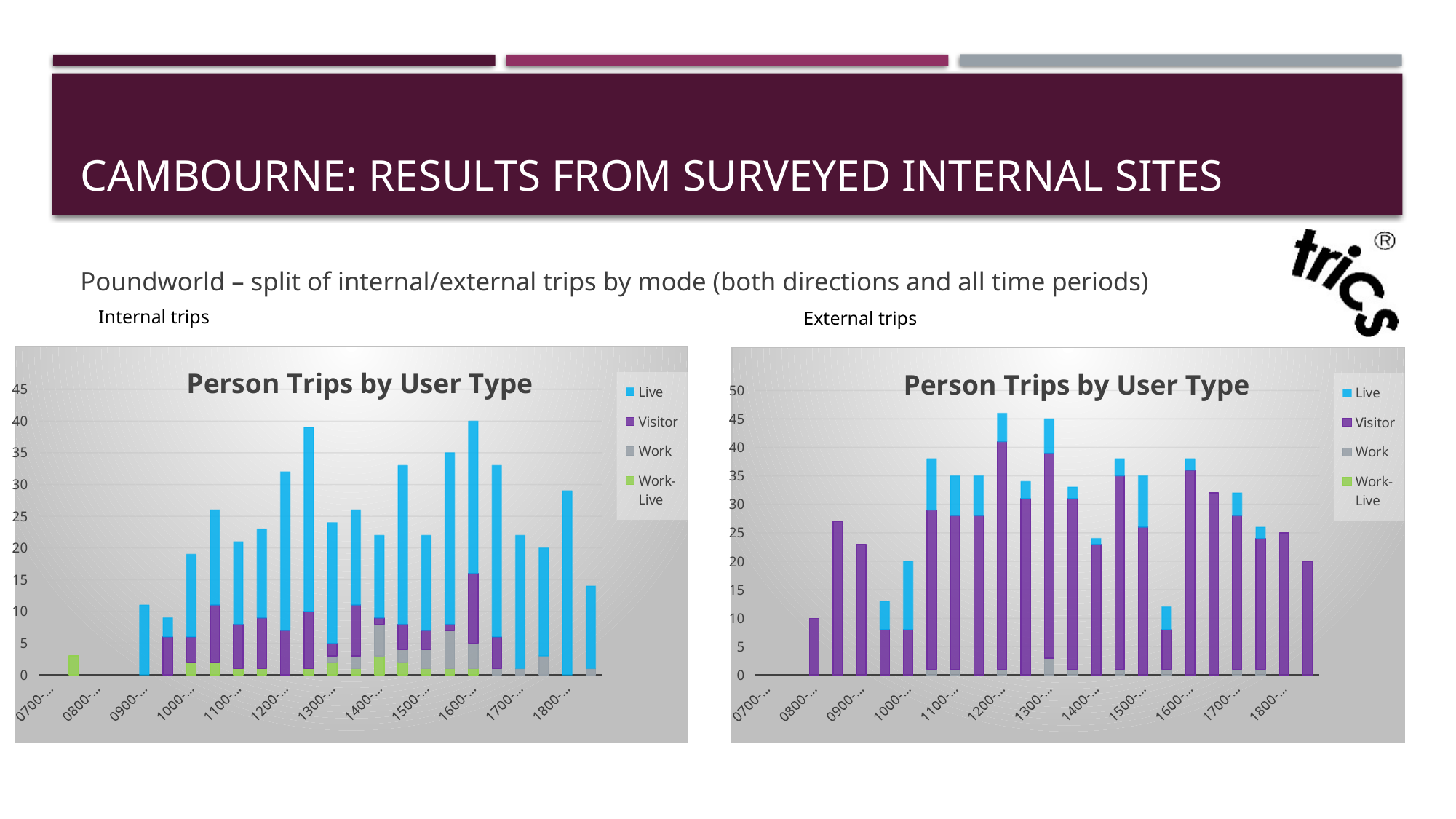
What kind of chart is the Internal trips chart? bar chart Which series makes up most of the bars in the External trips chart, Live or Visitor? Visitor In the External trips chart, which colour represents the Visitor series? purple In the External trips chart, is the first (leftmost) bar greater or less than 15? less In the Internal trips chart, is the tallest stacked bar greater or less than 35? greater In the Internal trips chart, which series does the first (leftmost) bar belong to? Work-Live Which series makes up most of the bars in the Internal trips chart, Live or Visitor? Live How many hourly labels are shown on the x axis of the External trips chart? 12 What is the title of the Internal trips chart? Person Trips by User Type How many series does the legend of the External trips chart list? 4 In the Internal trips chart, is the first (leftmost) bar greater or less than 5? less